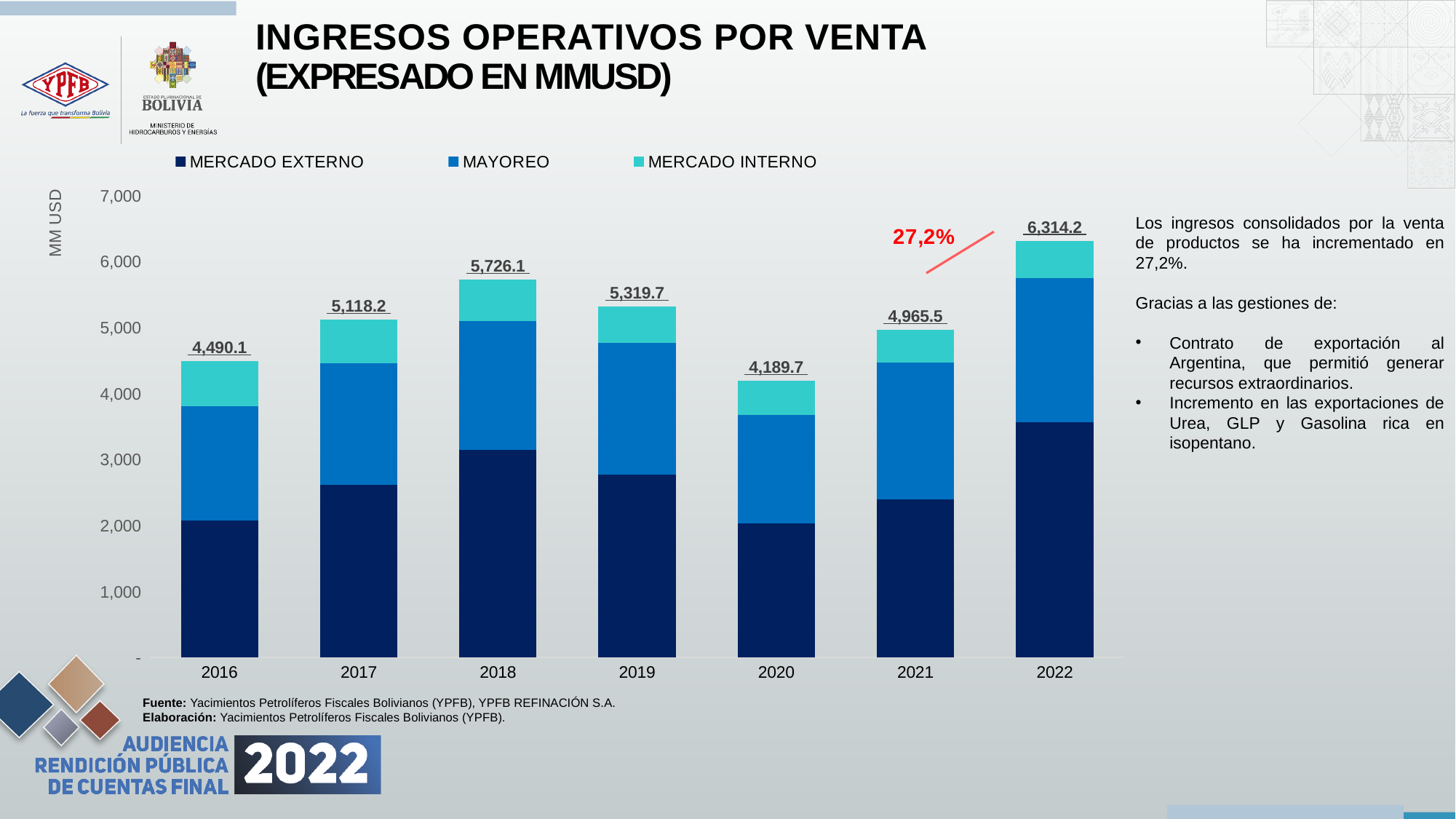
What kind of chart is shown on the slide? Stacked bar chart Is the MERCADO EXTERNO value for 2020 greater or less than 3,000? less How many years are shown on the x axis? 7 What is the total value labelled for 2020? 4,189.7 How many series does the legend list? 3 Do the total values rise or fall from 2020 to 2022? Rise Which year has the lowest total operating income? 2020 What is the difference between the 2022 total and the 2021 total? 1,348.7 What is the total operating income shown for 2022? 6,314.2 Which year has the highest total operating income? 2022 What is the total value labelled above the 2016 bar? 4,490.1 Which year has a larger total, 2018 or 2019? 2018